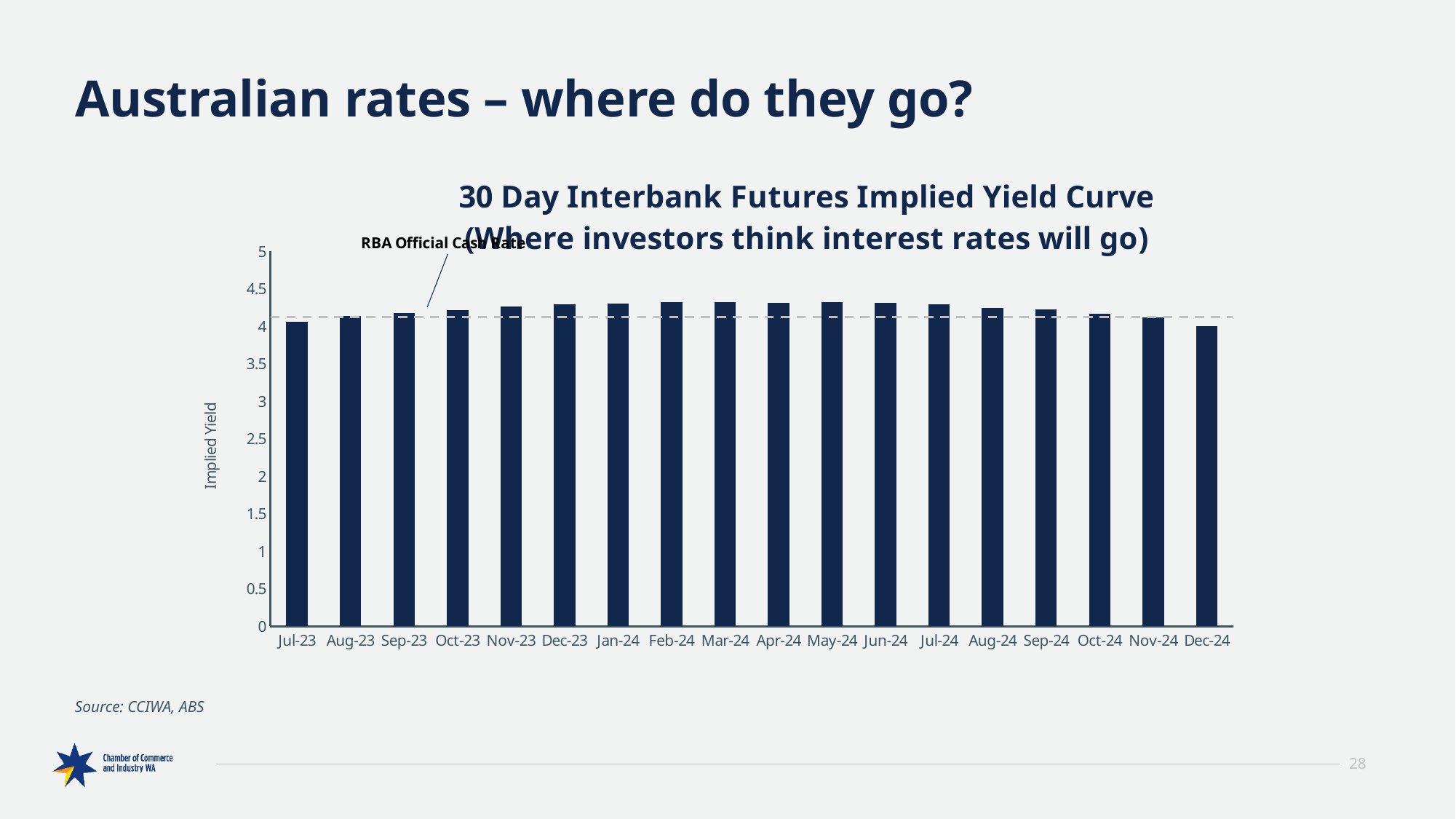
What does the dashed horizontal line on the chart represent? RBA Official Cash Rate Which is larger, the value for Jul-23 or the value for Mar-24? Mar-24 What is the title of the chart? 30 Day Interbank Futures Implied Yield Curve (Where investors think interest rates will go) What kind of chart is shown on the slide? Bar chart Is the value for Jul-23 greater or less than 3.5? greater What is the first month shown on the x axis? Jul-23 Is the value for Feb-24 greater or less than 4.5? less Is the value for Mar-24 greater or less than 4? greater Which is larger, the value for Feb-24 or the value for Dec-24? Feb-24 Which is larger, the value for Jun-24 or the value for Nov-24? Jun-24 How many months are plotted on the x axis of the chart? 18 How do the implied yield values change from Jul-23 to Dec-24 along the x axis? They rise to a peak in early-to-mid 2024, then fall